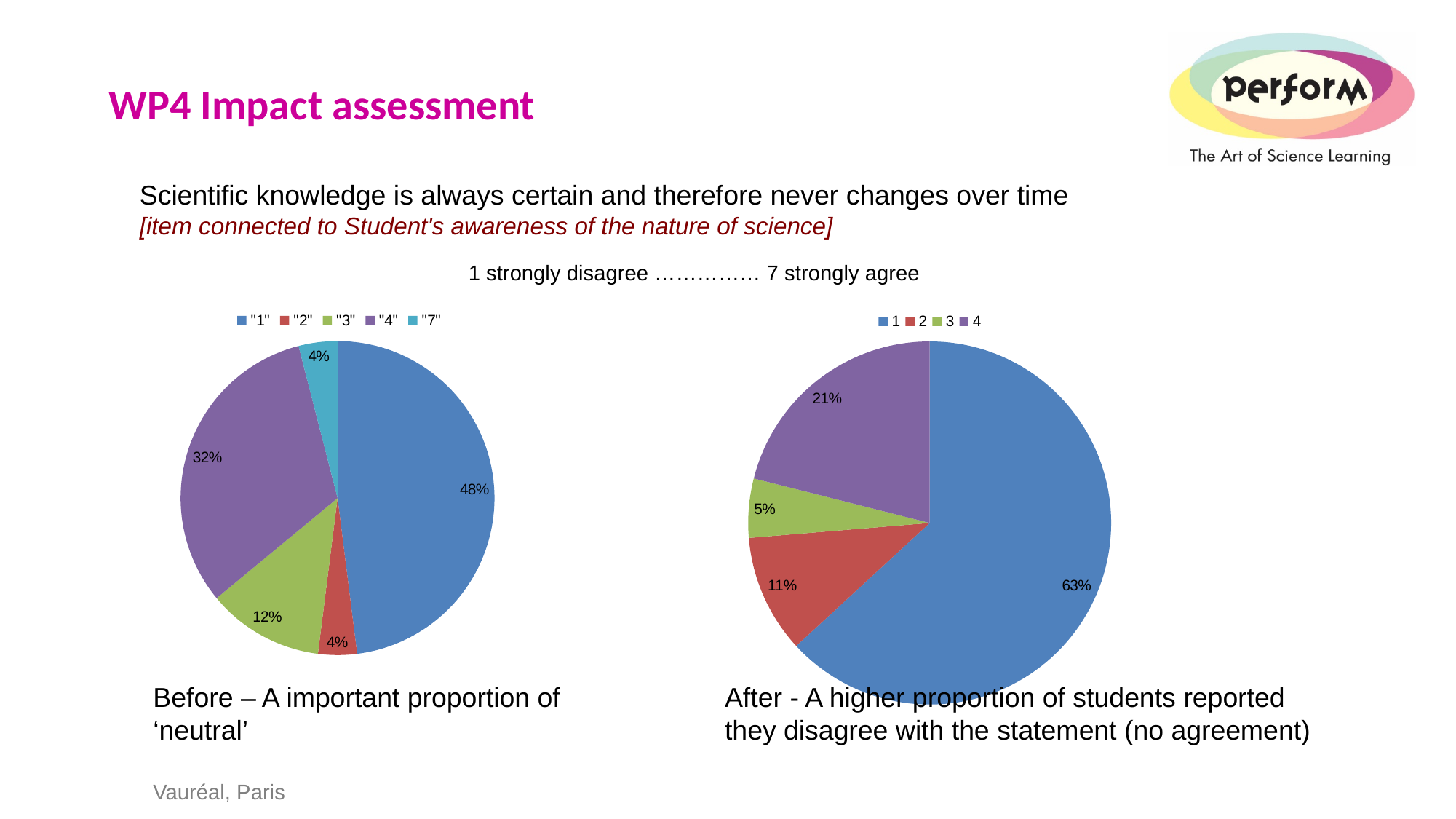
What is the difference between the share answering 1 in the right (After) chart and the share answering "1" in the left (Before) chart? 15 percentage points In the left (Before) pie chart, what share of students answered "3"? 12% In the right (After) pie chart, what share of students answered 4? 21% In the right (After) pie chart, what share of students answered 1? 63% In the right (After) pie chart, which response has the smallest share? 3 In the left (Before) pie chart, which response has the largest share? "1" In the left (Before) pie chart, what share of students answered "4"? 32% In the right (After) pie chart, what share of students answered 2? 11% How many slices does the left (Before) pie chart have? 5 How many entries does the legend of the right (After) pie chart list? 4 In the left (Before) pie chart, what share of students answered "1"? 48% What type of chart is used on the left side of the slide? Pie chart